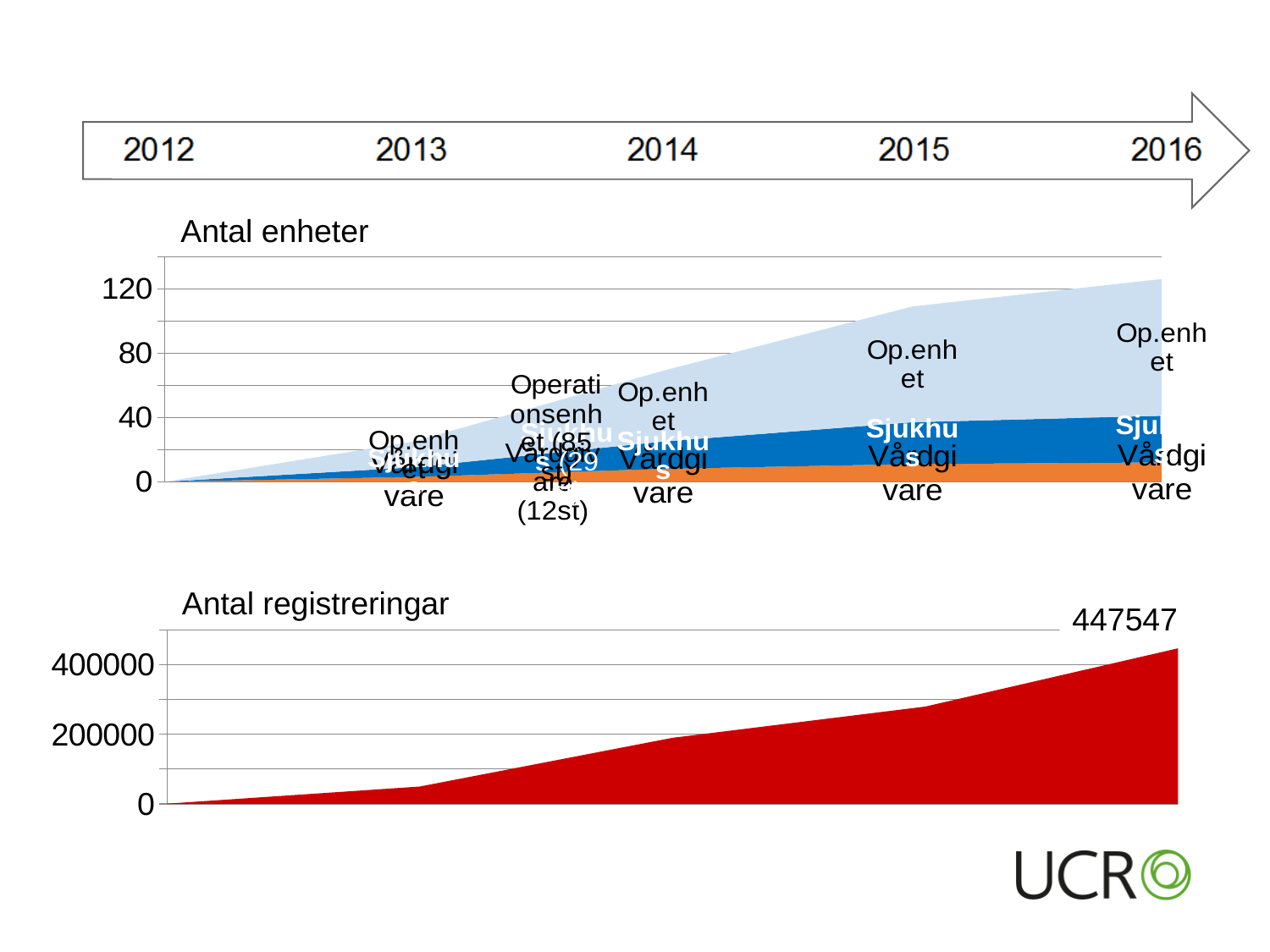
In the 'Antal enheter' chart, which series has the largest area in 2016? Op.enhet In the 'Antal registreringar' chart, do the values rise or fall from left to right? rise In the 'Antal enheter' chart, which series has the smallest area in 2016? Vårdgivare What kind of chart is the 'Antal registreringar' chart? area chart In the 'Antal enheter' chart, is the total number of units in 2015 greater or less than 80? greater What is the title of the top chart on the slide? Antal enheter What is the title of the bottom chart on the slide? Antal registreringar In the 'Antal registreringar' chart, what is the value printed at the end of the series? 447547 In the 'Antal registreringar' chart, is the final value greater or less than 400000? greater In the 'Antal enheter' chart, how many series are stacked? 3 How many years are shown on the timeline arrow above the charts? 5 In the 'Antal enheter' chart, does the total number of units rise or fall over time? rise